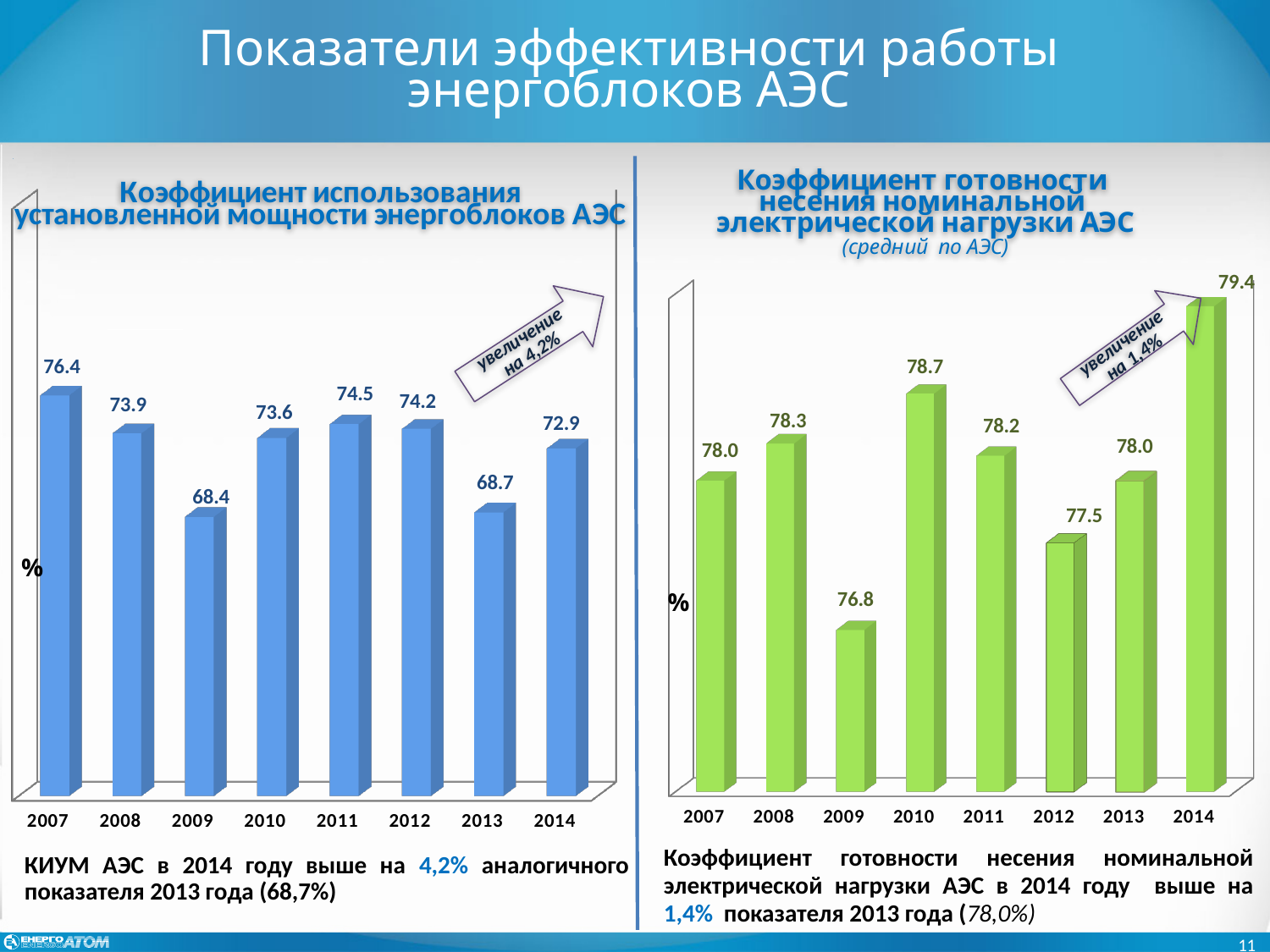
In the left chart, what is the value for 2014? 72.9 In the left chart, what is the difference between the 2014 value and the 2013 value? 4.2 In the right chart (Коэффициент готовности несения номинальной электрической нагрузки), what is the value for 2009? 76.8 What type of chart is the right chart? Bar chart In the right chart, which is larger: the value for 2010 or the value for 2012? 2010 In the left chart, which year has the lowest value? 2009 In the left chart (Коэффициент использования установленной мощности), what is the value for 2007? 76.4 In the right chart, what is the value for 2014? 79.4 In the left chart, which year has the highest value? 2007 In the right chart, which year has the lowest value? 2009 How many years are shown on the x axis of the left chart? 8 In the right chart, which year has the highest value? 2014